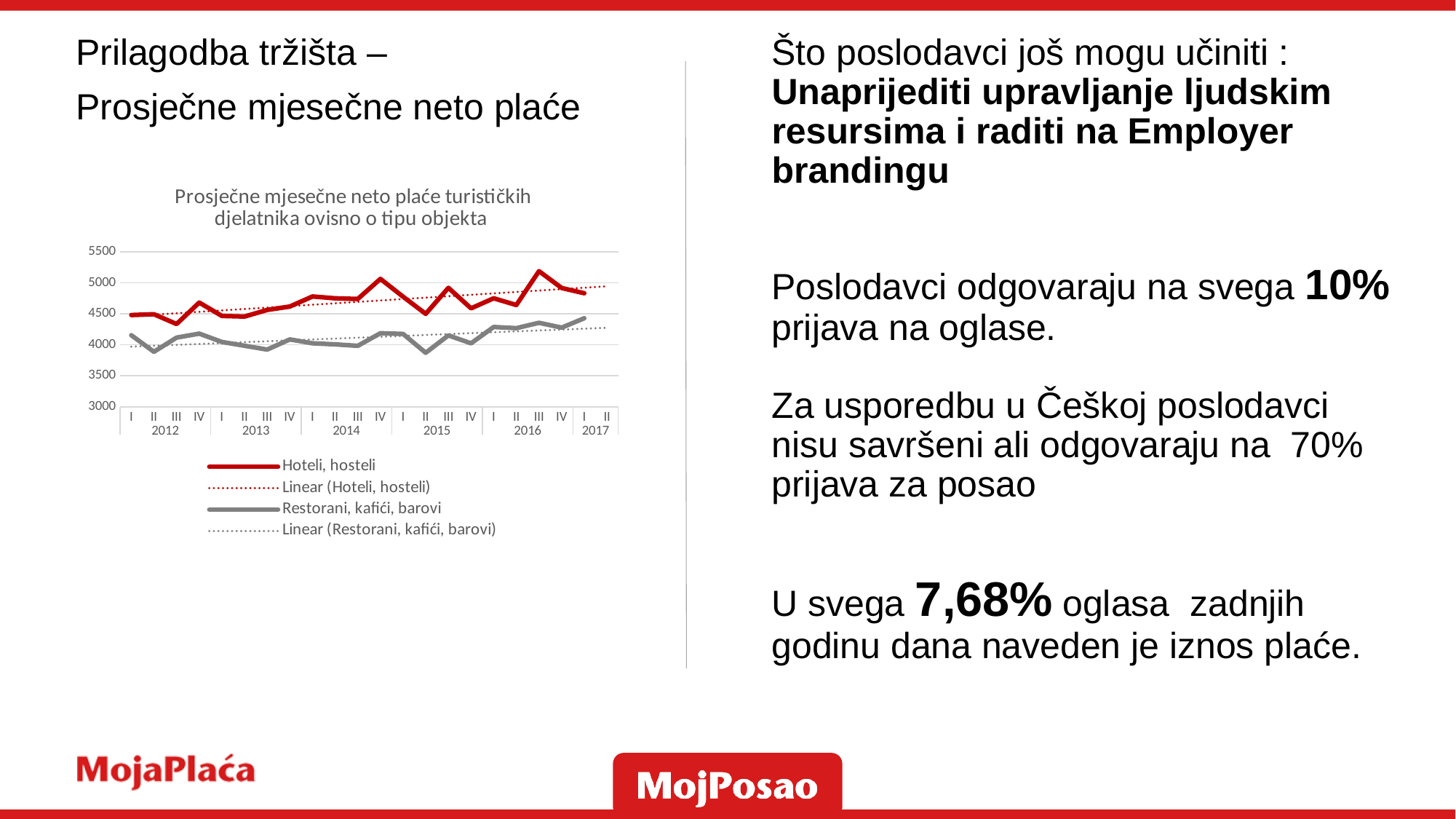
Which series has the higher value in quarter IV of 2014, Hoteli, hosteli or Restorani, kafići, barovi? Hoteli, hosteli How many quarterly data points are plotted along the x axis of the chart? 21 What is the title of the chart? Prosječne mjesečne neto plaće turističkih djelatnika ovisno o tipu objekta What kind of chart is shown on the slide? line chart How many entries does the chart legend list? 4 Is the value for Restorani, kafići, barovi in quarter II of 2012 greater or less than 4000? less Is the value for Hoteli, hosteli in quarter III of 2016 greater or less than 5000? greater What colour is the line for Hoteli, hosteli in the chart? red Is the value for Hoteli, hosteli in quarter I of 2012 greater or less than 5000? less Does the Restorani, kafići, barovi series generally rise or fall from 2012 to 2017? rise In which quarter does the Hoteli, hosteli series reach its highest value? III 2016